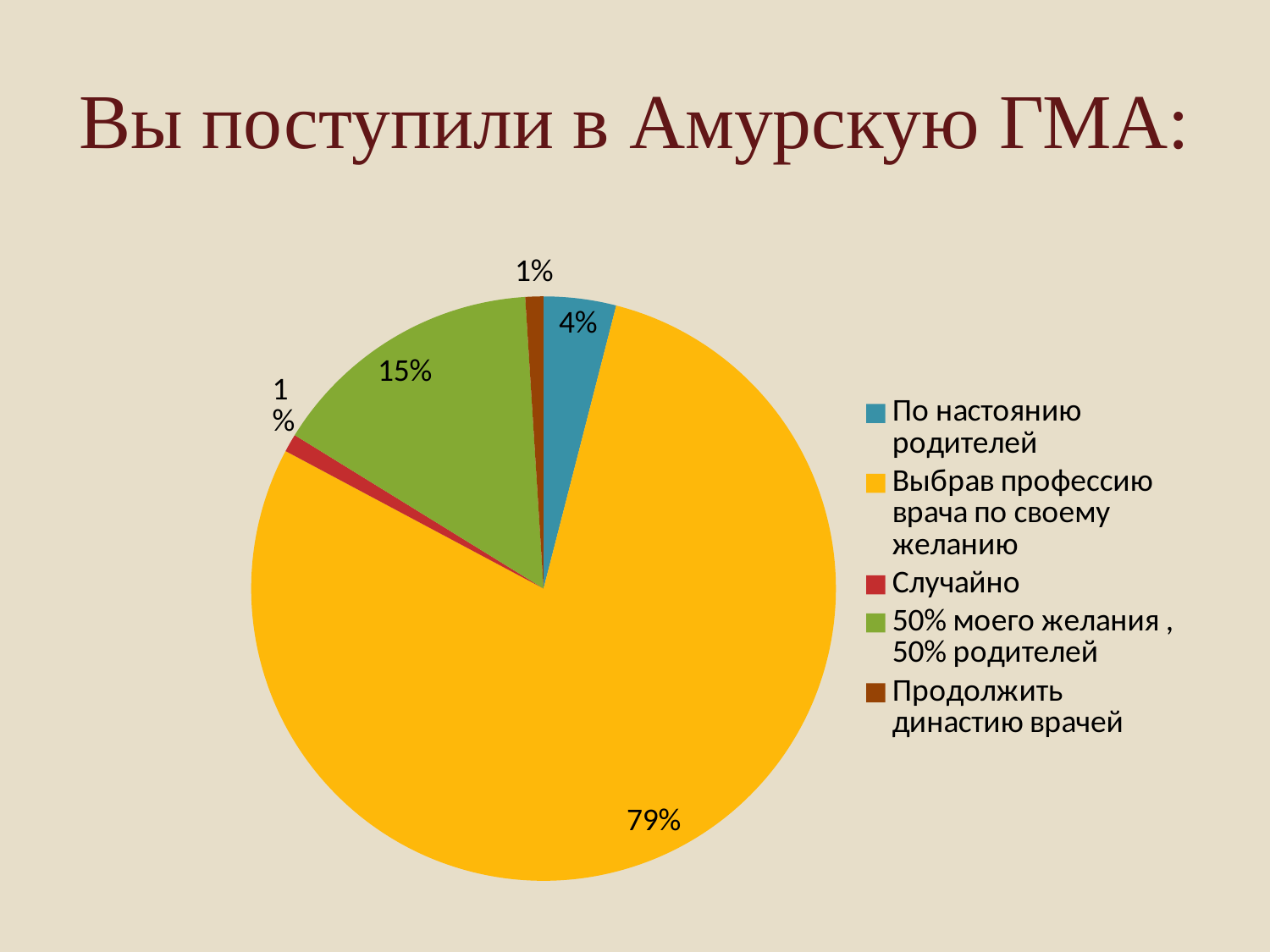
What type of chart is shown on the slide? pie chart What share of the pie is labelled "Выбрав профессию врача по своему желанию"? 79% What is the difference between the shares for "Выбрав профессию врача по своему желанию" and "50% моего желания , 50% родителей"? 64% What share of the pie is labelled "Продолжить династию врачей"? 1% Which is larger: the share for "50% моего желания , 50% родителей" or the share for "По настоянию родителей"? 50% моего желания , 50% родителей Which category has the largest slice of the pie? Выбрав профессию врача по своему желанию How many entries does the legend list? 5 What share of the pie is labelled "Случайно"? 1% What is the title of the slide above the pie chart? Вы поступили в Амурскую ГМА: How many slices does the pie chart have? 5